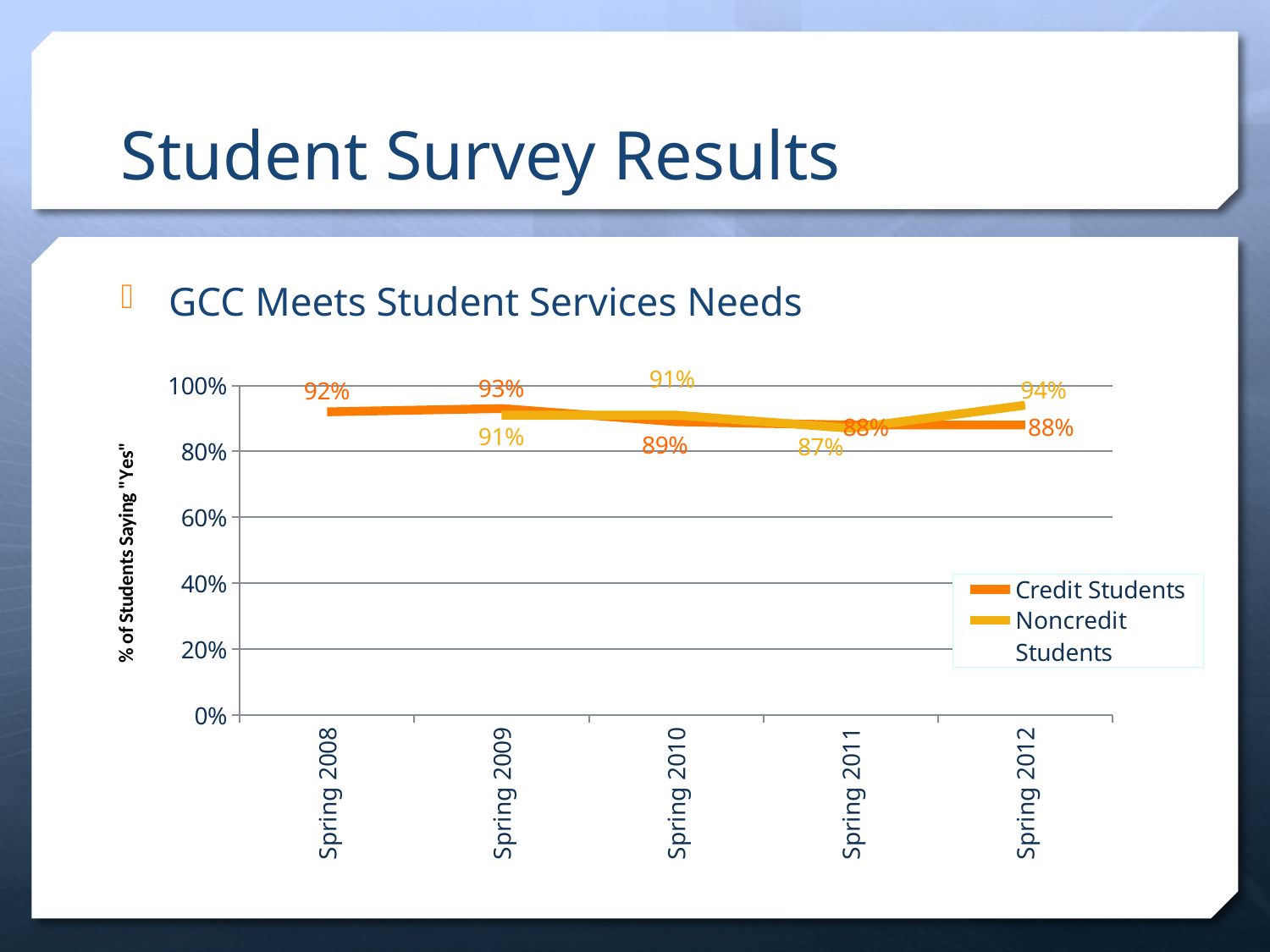
What is the value for Noncredit Students in Spring 2011? 87% What is the value for Credit Students in Spring 2010? 89% What is the value for Noncredit Students in Spring 2012? 94% In which term did Noncredit Students have their lowest value? Spring 2011 What kind of chart is shown on the slide? Line chart How many series does the legend list? 2 Do the Credit Students values rise or fall from Spring 2009 to Spring 2011? Fall In Spring 2012, how much higher is the Noncredit Students value than the Credit Students value? 6 percentage points In which term did Credit Students have their highest value? Spring 2009 In Spring 2011, which series has the larger value, Credit Students or Noncredit Students? Credit Students How many terms are shown on the x axis? 5 What is the value for Credit Students in Spring 2008? 92%